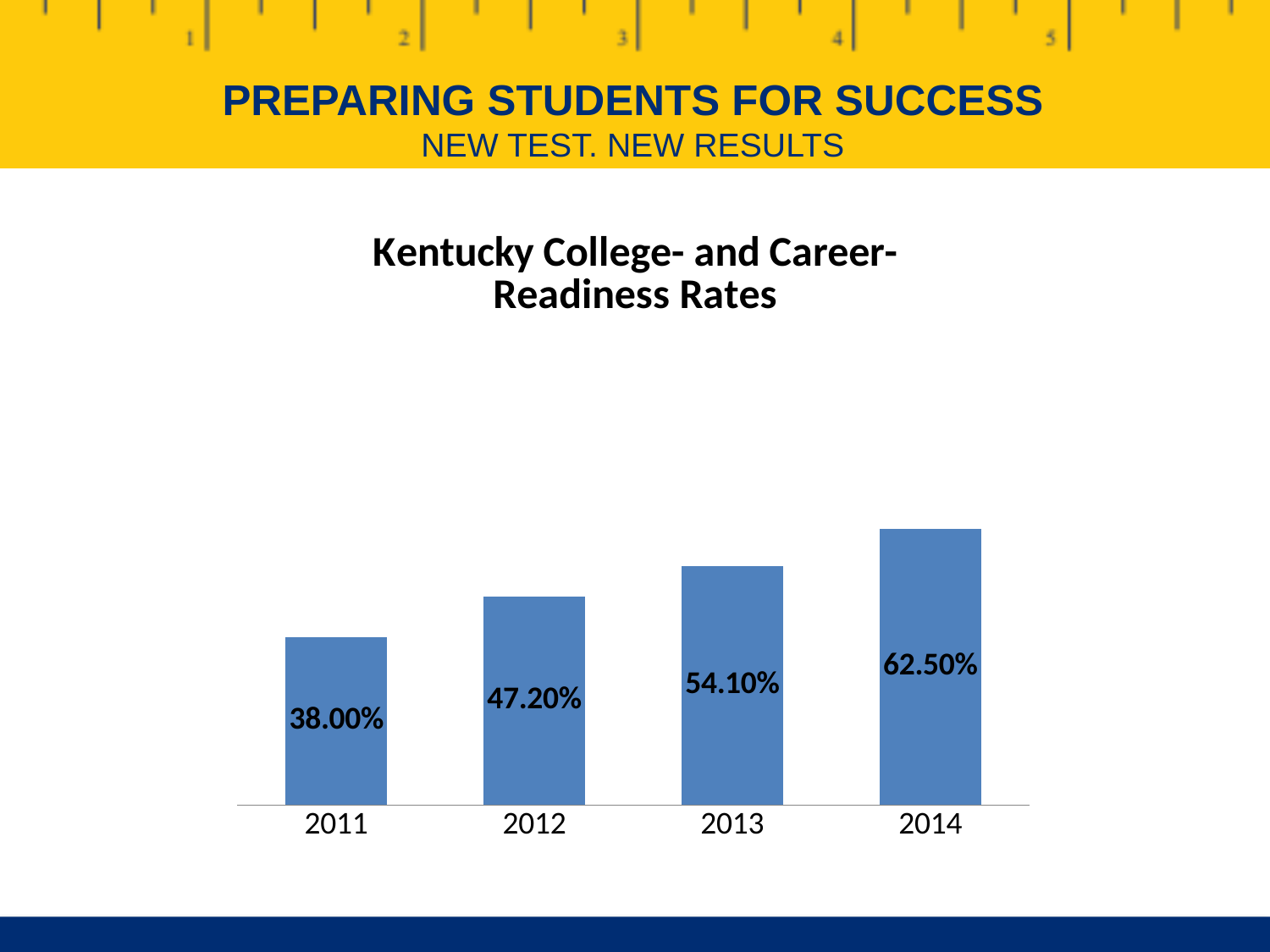
Which year has the highest college- and career-readiness rate? 2014 What is the difference between the 2014 rate and the 2011 rate? 24.50% Which year has a higher rate, 2012 or 2013? 2013 What is the college- and career-readiness rate for 2011? 38.00% What is the title of the chart? Kentucky College- and Career-Readiness Rates What is the college- and career-readiness rate for 2014? 62.50% Do the readiness rates rise or fall from 2011 to 2014? Rise How many years are shown on the chart? 4 What is the college- and career-readiness rate for 2013? 54.10% What is the difference between the 2012 rate and the 2011 rate? 9.20% Which year has the lowest college- and career-readiness rate? 2011 What kind of chart is shown on the slide? Bar chart